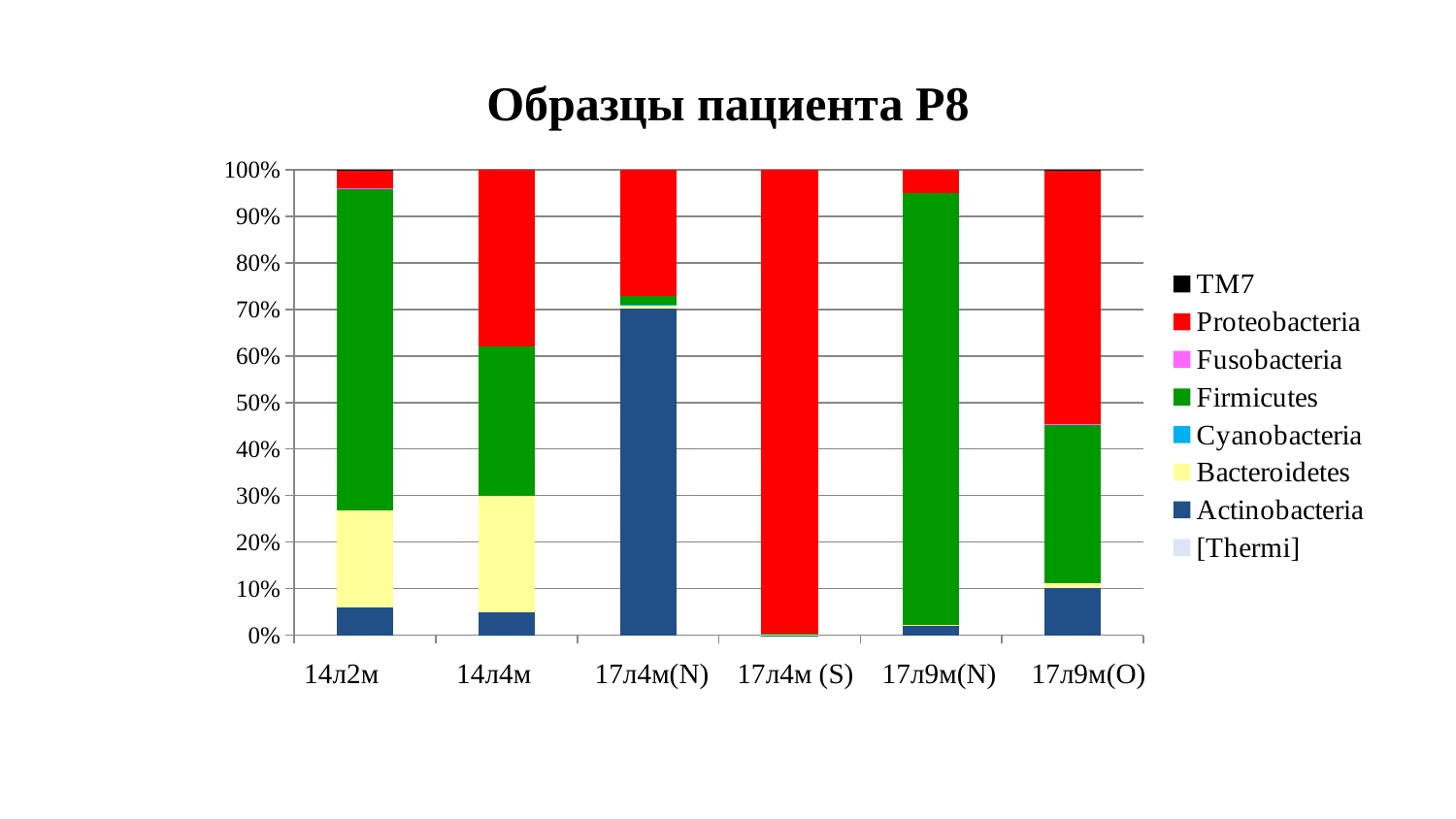
What does each stacked bar total? 100% Which sample has the largest Proteobacteria share? 17л4м (S) How many sample categories are shown along the x axis? 6 Is the Actinobacteria share in sample 17л4м(N) greater or less than 60%? greater What is the title of the chart? Образцы пациента P8 Which sample has the largest Actinobacteria share? 17л4м(N) What kind of chart is shown on the slide? Stacked bar chart Is the Firmicutes share in sample 14л4м greater or less than 40%? less How many series does the legend list? 8 Which colour represents Proteobacteria in the chart? Red Which sample has a larger Firmicutes share, 14л2м or 14л4м? 14л2м Is the Proteobacteria share in sample 17л9м(O) greater or less than 40%? greater